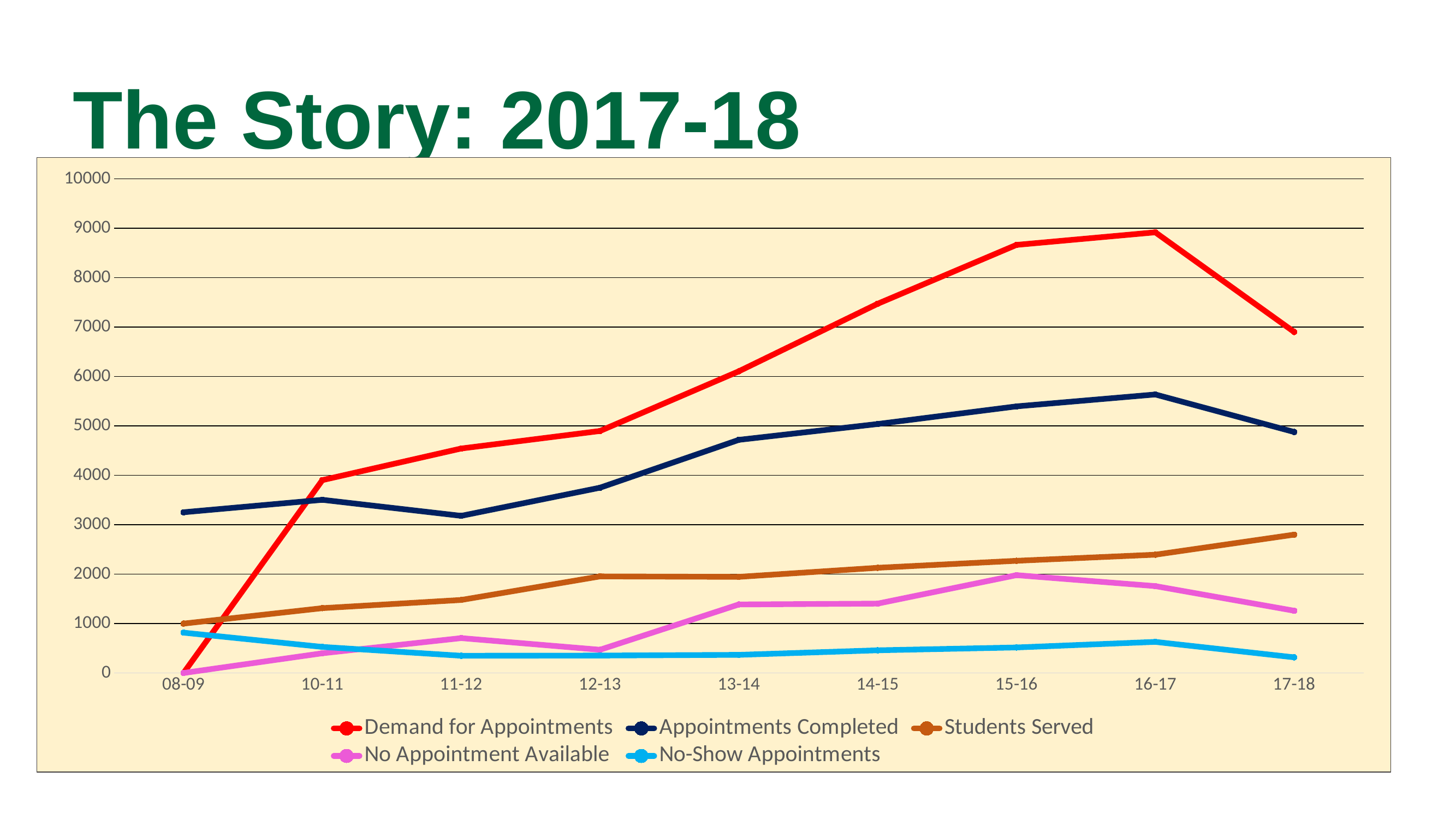
Does Demand for Appointments rise or fall between 16-17 and 17-18? fall Which is larger in 16-17: No Appointment Available or No-Show Appointments? No Appointment Available Is the value for Demand for Appointments in 15-16 greater or less than 8000? greater Is the value for Students Served in 17-18 greater or less than 2000? greater How many series does the legend list? 5 Does the Students Served line generally rise or fall from 08-09 to 17-18? rise Is the value for Appointments Completed in 17-18 greater or less than 5000? less Which series is drawn in red? Demand for Appointments In which year is Appointments Completed at its lowest? 11-12 In which year does Demand for Appointments reach its highest value? 16-17 How many academic years are plotted along the x axis? 9 What kind of chart is shown on the slide? line chart